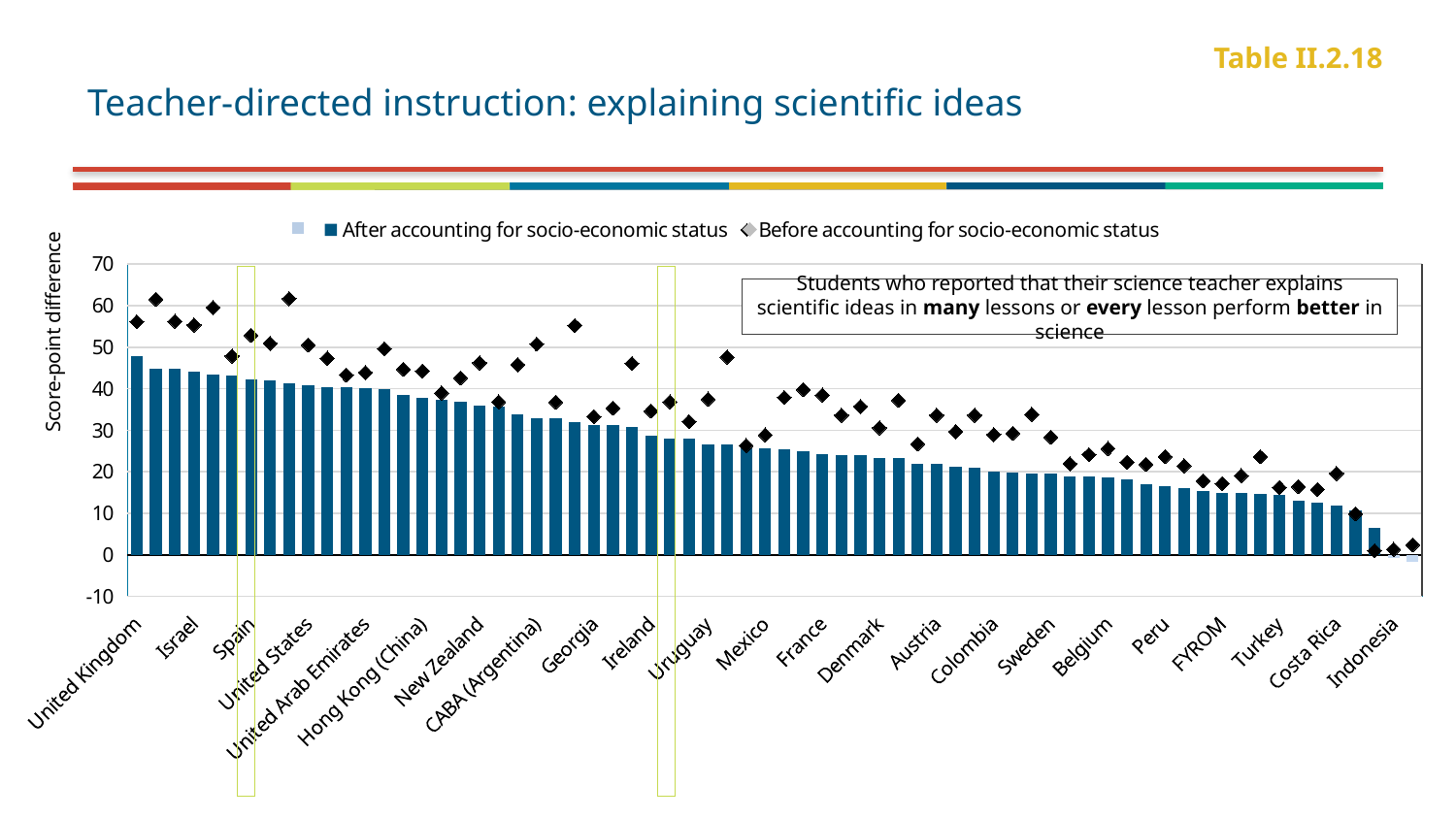
What is the title of the chart on the slide? Teacher-directed instruction: explaining scientific ideas Is the bar value for the United Kingdom greater or less than 40? greater Is the bar value for Turkey greater or less than 20? less Which has the larger bar value, Mexico or Turkey? Mexico Which labelled country has the highest bar (after accounting for socio-economic status)? United Kingdom Is the 'Before accounting for socio-economic status' value for Israel greater or less than 50? greater Which labelled country has the lowest bar (after accounting for socio-economic status)? Indonesia What kind of chart is shown on the slide? bar chart What is the label of the vertical axis? Score-point difference Do the bar values rise or fall moving from left to right along the x axis? fall Which series is shown with diamond markers rather than bars? Before accounting for socio-economic status